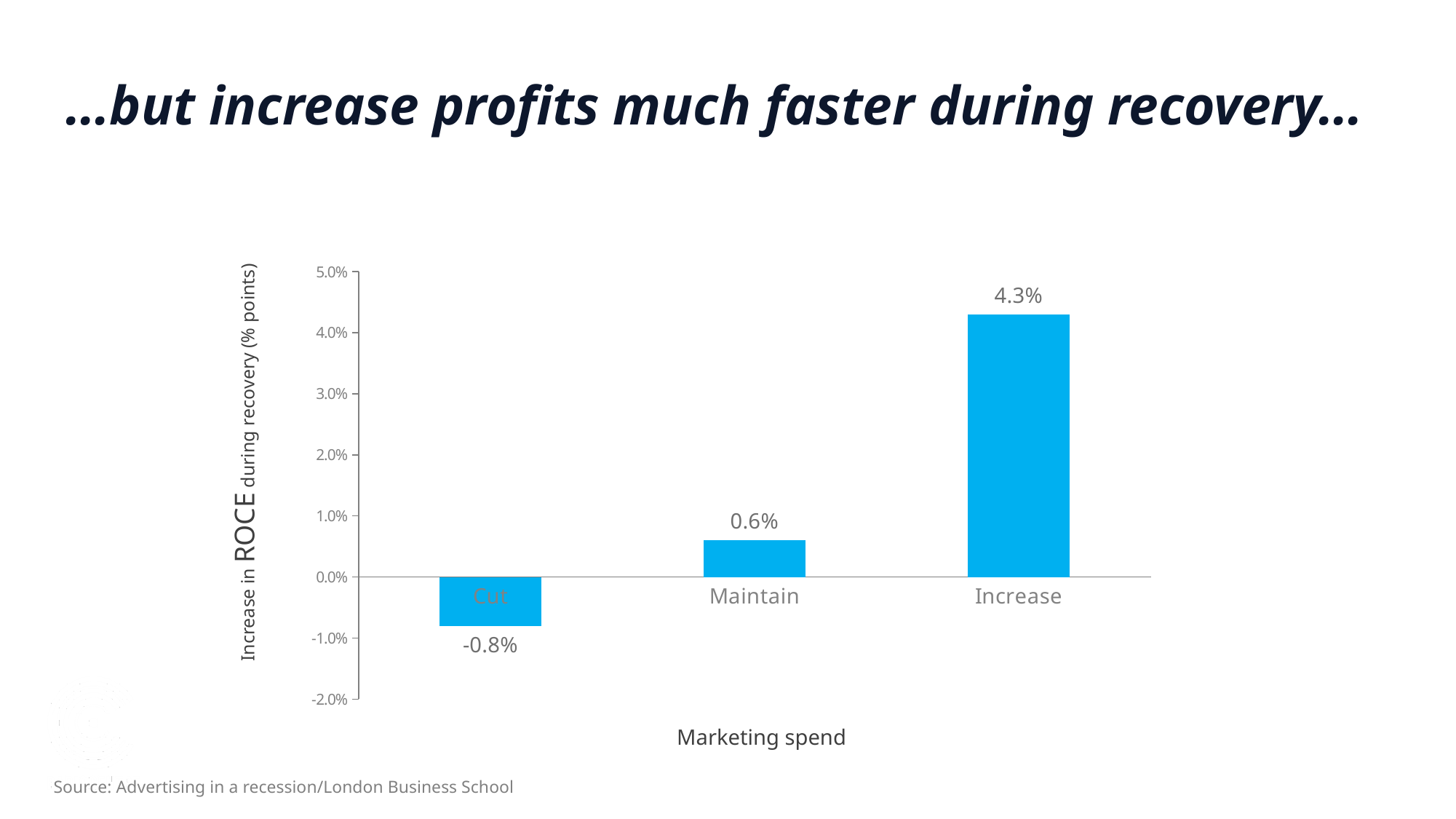
What is the increase in ROCE during recovery for the Cut marketing spend category? -0.8% What is the difference between the Maintain and Cut values? 1.4% What is the increase in ROCE during recovery for the Increase category? 4.3% What kind of chart is shown on the slide? Bar chart What is the label of the x axis? Marketing spend Which marketing spend category has the highest increase in ROCE during recovery? Increase What is the difference between the Increase and Maintain values? 3.7% Which is larger, the value for Maintain or the value for Cut? Maintain How many marketing spend categories are shown on the chart? 3 Is the value for Increase greater or less than 4.0%? greater Which marketing spend category has the lowest increase in ROCE during recovery? Cut What is the increase in ROCE during recovery for the Maintain category? 0.6%